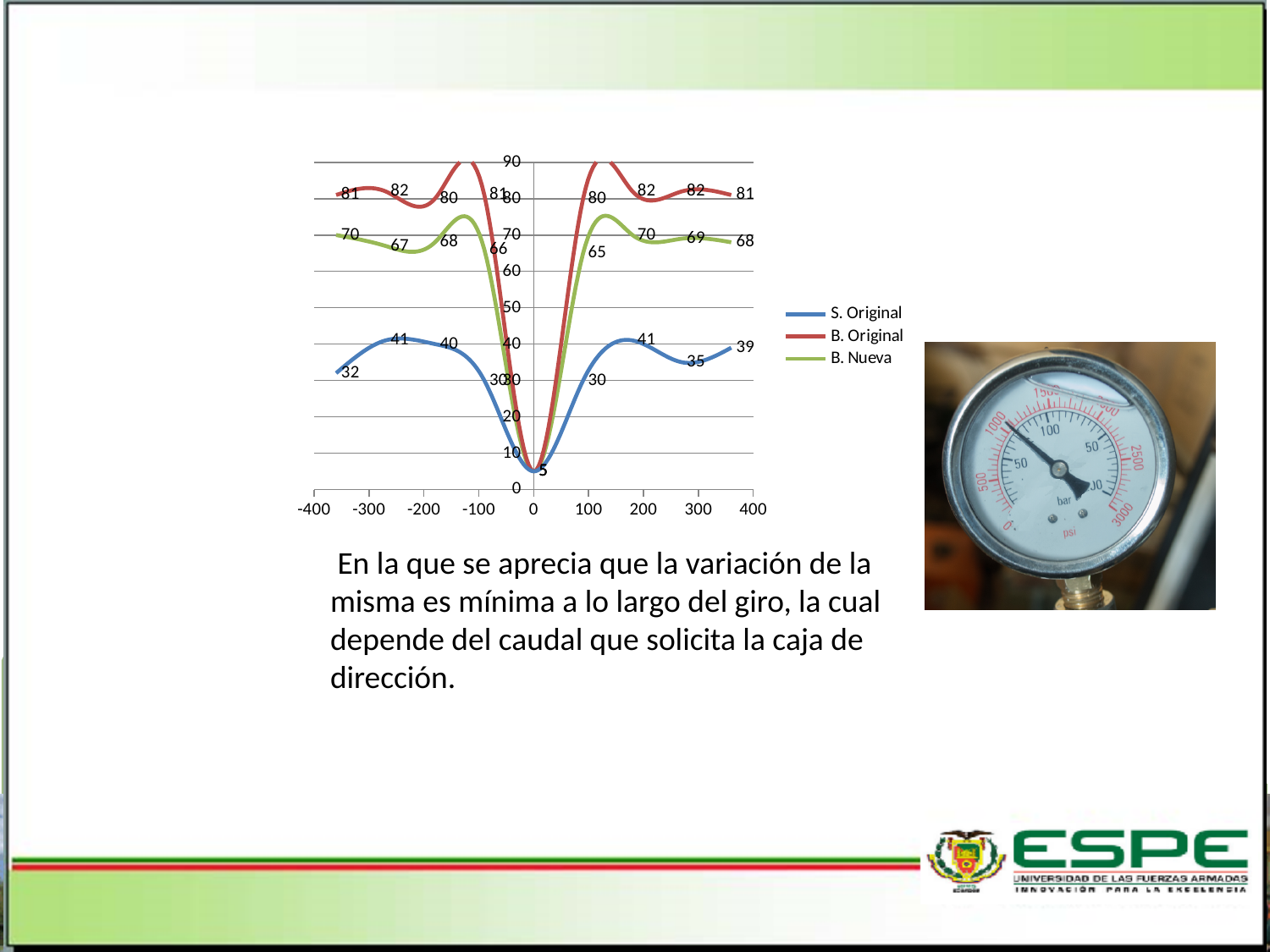
What is the leftmost data label on the S. Original line? 32 At the far right of the chart, which series is higher, B. Original or S. Original? B. Original Which series is drawn in blue according to the legend? S. Original What are the three series names listed in the legend? S. Original, B. Original, B. Nueva What value is labeled at x = 0, where the three lines meet at their lowest point? 5 How many series does the legend list? 3 What is the difference between the rightmost labels of B. Original (81) and B. Nueva (68)? 13 What kind of chart is shown on the slide? line chart What is the highest labeled value on the S. Original line? 41 What is the rightmost data label on the B. Nueva line? 68 What is the highest labeled value on the B. Original line? 82 What is the rightmost data label on the B. Original line? 81